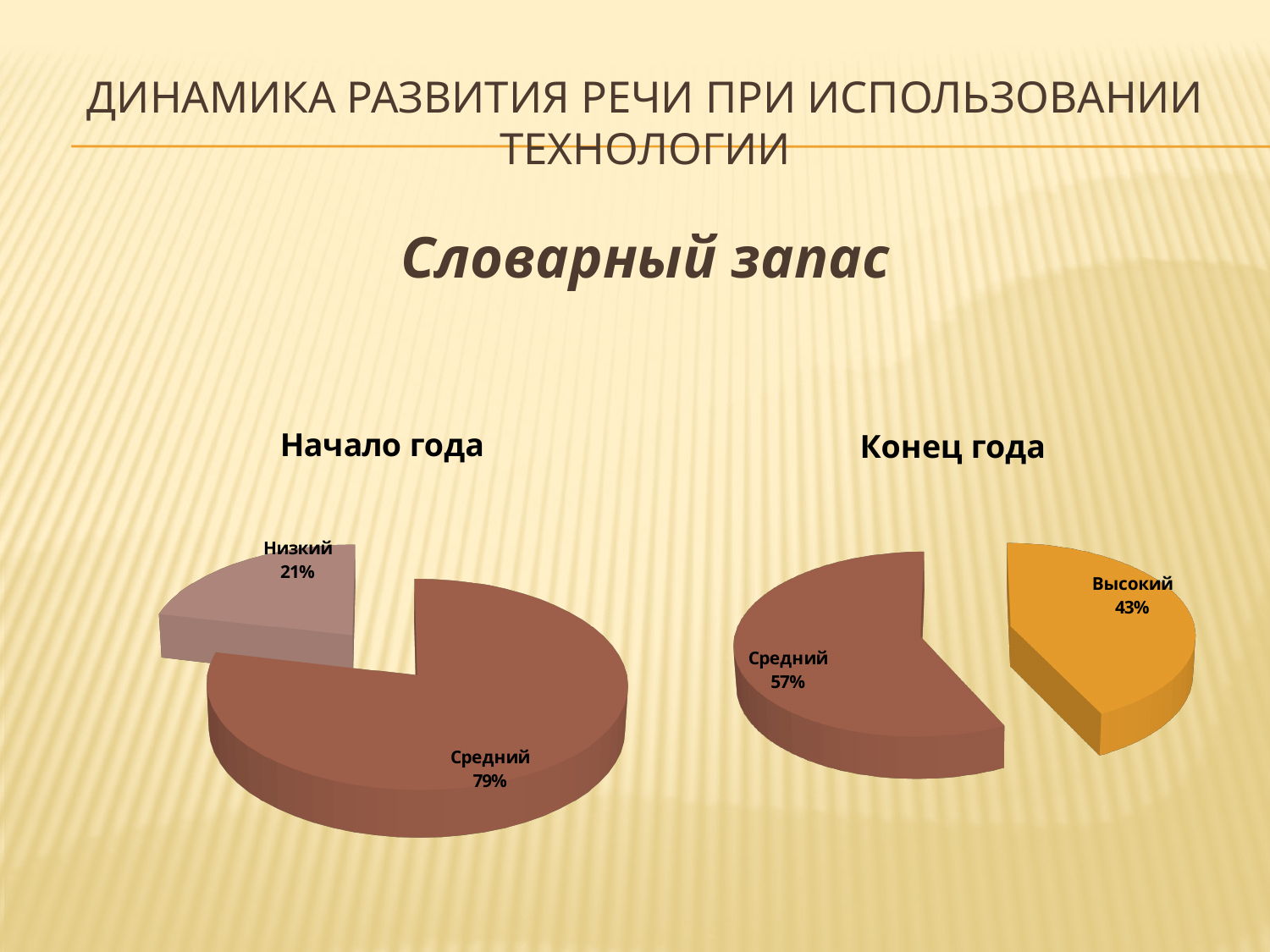
In the "Начало года" chart, which category has the largest share? Средний In the "Начало года" chart, what is the difference between Средний and Низкий? 58% In the "Начало года" chart, what is the value for Средний? 79% Which is larger: Средний in the "Начало года" chart or Средний in the "Конец года" chart? Средний in Начало года What kind of chart is the "Начало года" chart? Pie chart In the "Конец года" chart, what is the value for Высокий? 43% In the "Начало года" chart, what is the value for Низкий? 21% In the "Конец года" chart, what is the value for Средний? 57% In the "Конец года" chart, which category has the smallest share? Высокий In the "Конец года" chart, what is the difference between Средний and Высокий? 14% What is the title of the chart on the right of the slide? Конец года How many categories does the "Конец года" chart show? 2